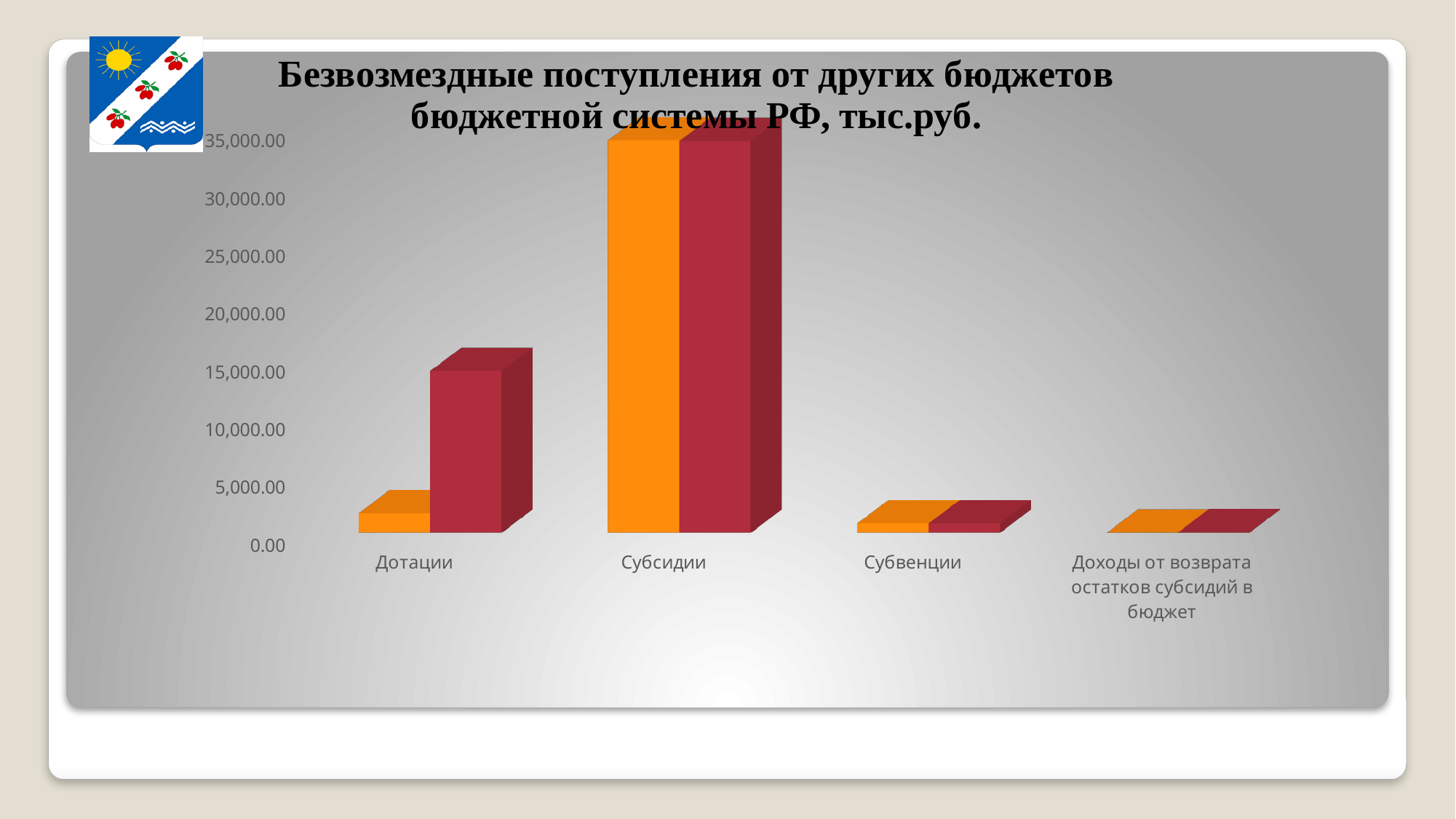
What kind of chart is shown on the slide? bar chart Which category has the highest bars in the chart? Субсидии Is the value of the orange bar for Дотации greater or less than 5,000.00? less Which category has larger bars, Дотации or Субвенции? Дотации What is the title of the chart? Безвозмездные поступления от других бюджетов бюджетной системы РФ, тыс.руб. Is the value of the red bar for Субвенции greater or less than 5,000.00? less For Дотации, which bar is larger, the orange one or the red one? the red one How many categories are shown on the x axis of the chart? 4 Which category has the lowest bars in the chart? Доходы от возврата остатков субсидий в бюджет Is the value of the orange bar for Субсидии greater or less than 30,000.00? greater What is the highest value shown on the vertical axis of the chart? 35,000.00